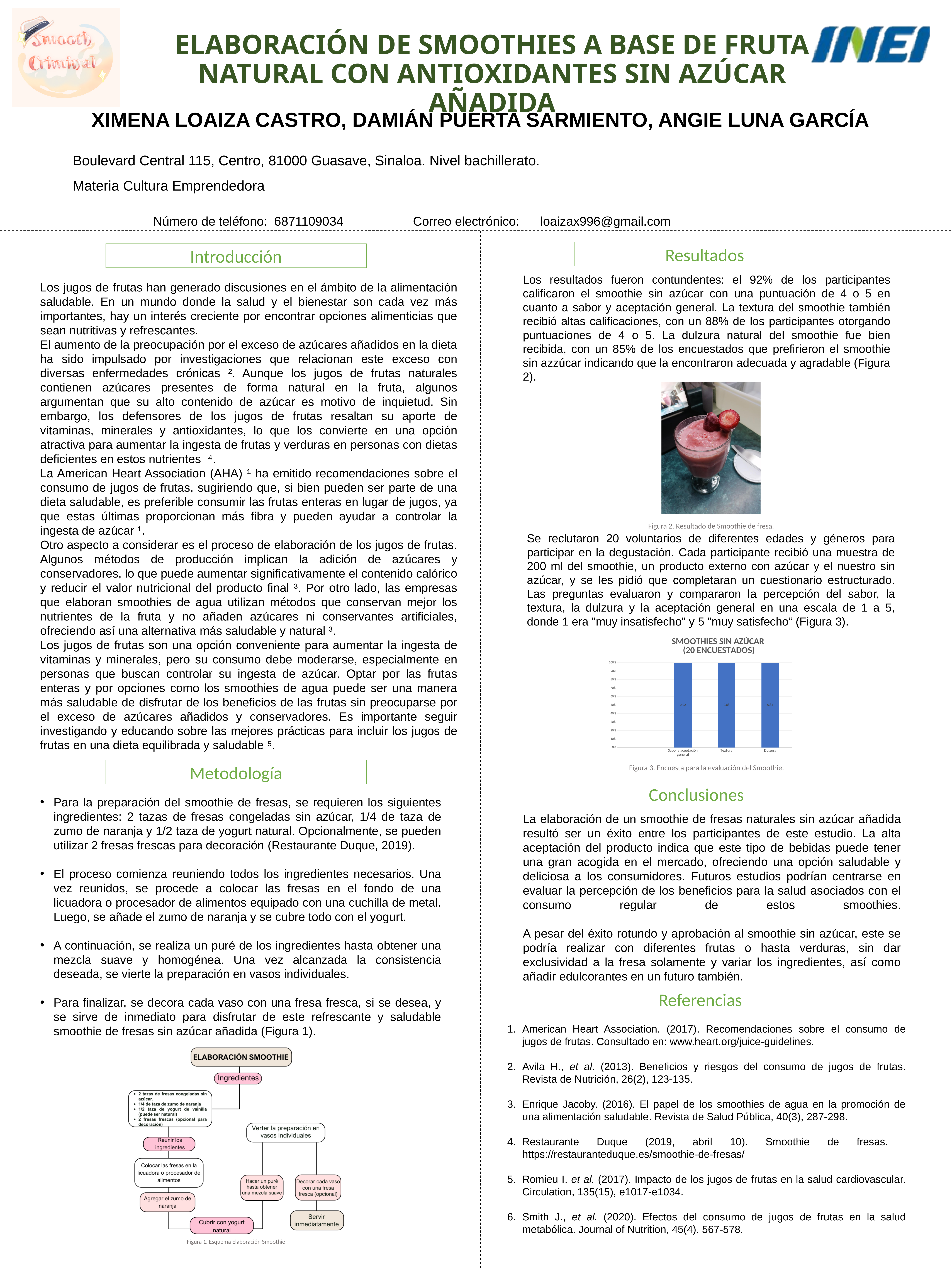
How many categories are plotted in the Figura 3 chart? 3 In the Figura 3 chart, is the value for Sabor y aceptación general greater or less than 60%? greater What is the title of the chart in Figura 3? SMOOTHIES SIN AZÚCAR (20 ENCUESTADOS) In the Figura 3 chart, is the value for Textura greater or less than 80%? greater In the Figura 3 chart, is the value for Textura greater or less than 50%? greater What is the highest tick shown on the vertical axis of the Figura 3 chart? 100% What kind of chart is shown in Figura 3? bar chart